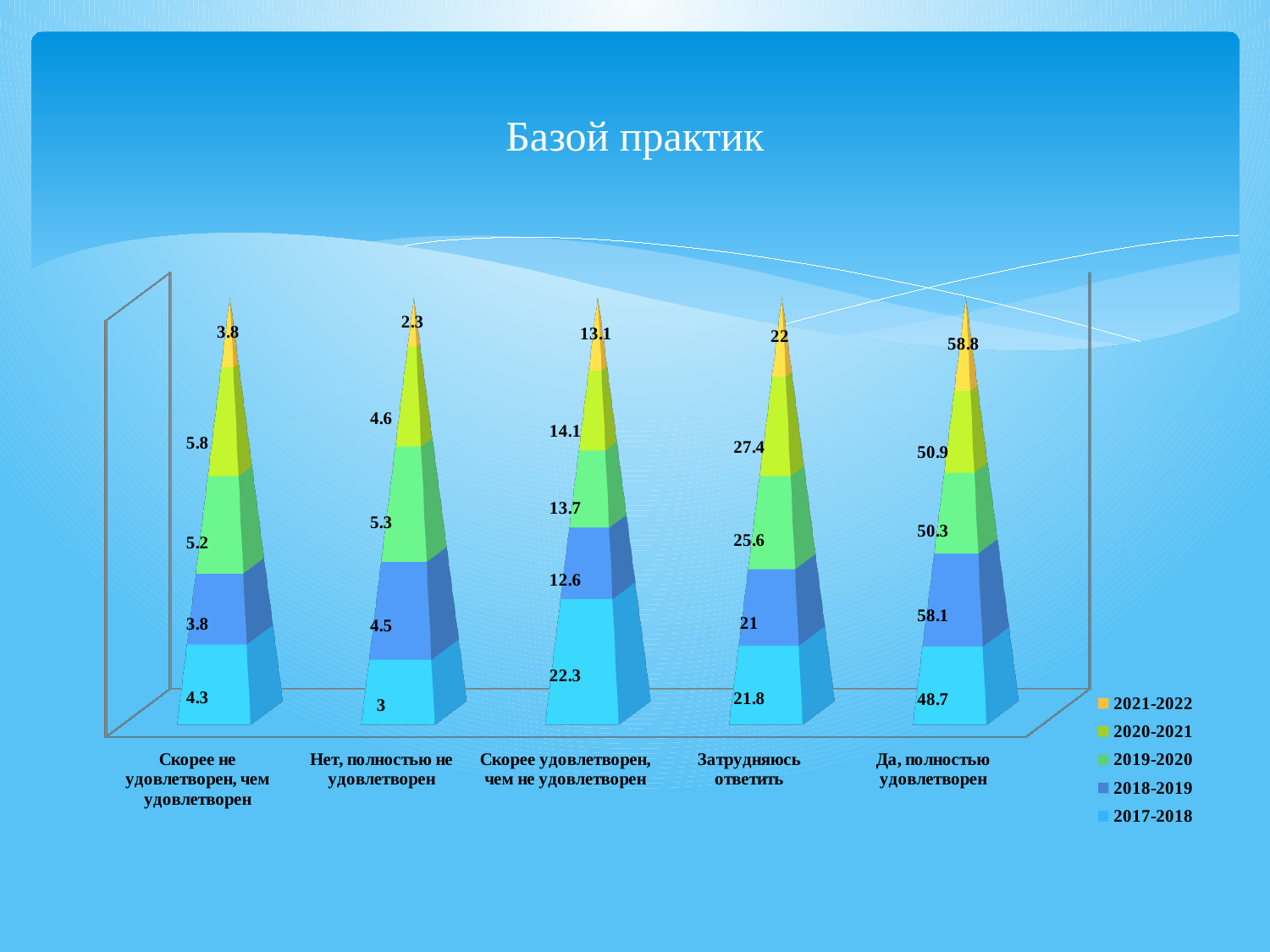
Which category has the highest value in the 2021-2022 series? Да, полностью удовлетворен How many series does the legend list? 5 What kind of chart is shown on the slide? Stacked bar chart (3D pyramid) What is the value for 'Скорее удовлетворен, чем не удовлетворен' in the 2017-2018 series? 22.3 Which category has the lowest value in the 2017-2018 series? Нет, полностью не удовлетворен Which is larger for 'Затрудняюсь ответить': the 2020-2021 value or the 2019-2020 value? 2020-2021 What is the value for 'Да, полностью удовлетворен' in the 2021-2022 series? 58.8 What is the value for 'Затрудняюсь ответить' in the 2019-2020 series? 25.6 What is the title of the chart? Базой практик What is the difference between the 2018-2019 and 2017-2018 values for 'Да, полностью удовлетворен'? 9.4 How many categories are shown on the x axis? 5 What is the value for 'Нет, полностью не удовлетворен' in the 2018-2019 series? 4.5